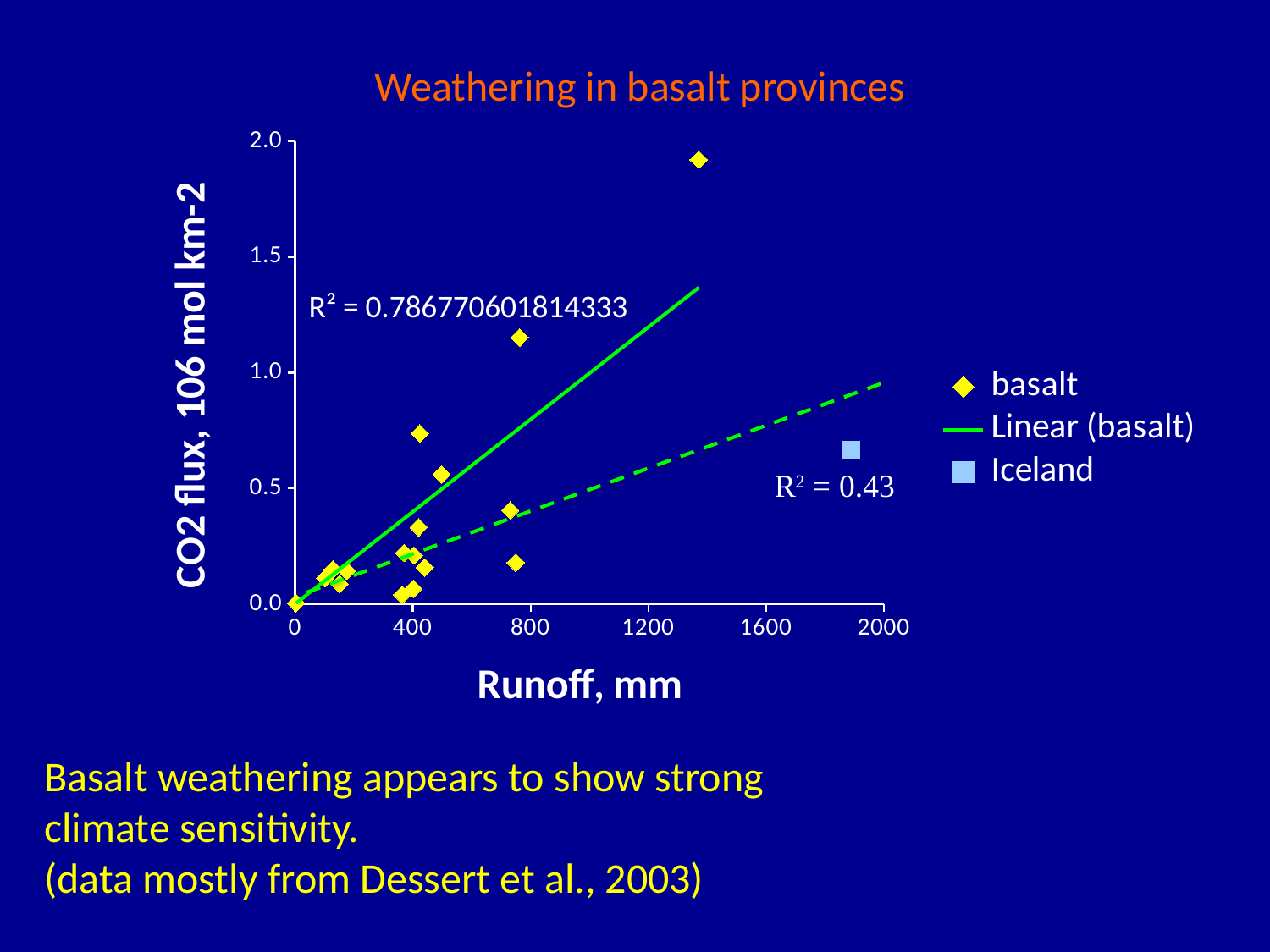
Does the CO2 flux for basalt generally rise or fall as runoff increases? rise Which series contains the point with the highest CO2 flux on the chart? basalt What kind of chart is shown on the slide? scatter chart What are the entries listed in the chart legend? basalt, Linear (basalt), Iceland What R² value is printed next to the solid linear trend line for basalt? R² = 0.786770601814333 Which has the higher CO2 flux: the Iceland point or the highest basalt point? the highest basalt point Is the CO2 flux value of the highest basalt point greater or less than 1.5? greater What is the title of the chart? Weathering in basalt provinces What R² value is printed near the dashed trend line? R² = 0.43 Is the runoff value of the Iceland point greater or less than 1600 mm? greater Is the CO2 flux value of the Iceland point greater or less than 1.0? less How many entries does the chart legend list? 3